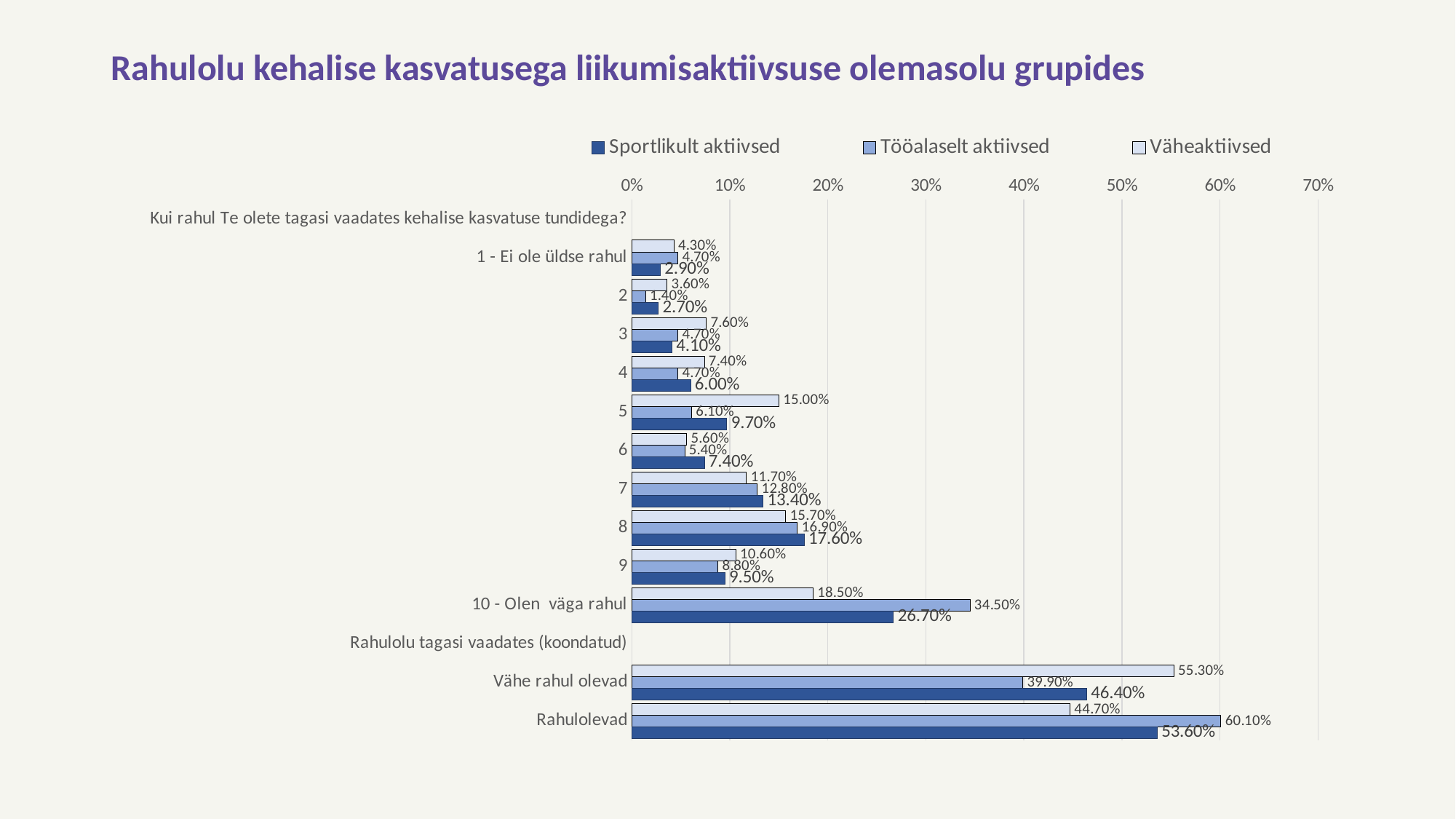
Which series has the highest value in the category '10 - Olen väga rahul'? Tööalaselt aktiivsed What is the value for Tööalaselt aktiivsed in the category 'Rahulolevad'? 60.10% How many series does the legend list? 3 What is the value for Väheaktiivsed in the category 'Vähe rahul olevad'? 55.30% What is the difference between the Tööalaselt aktiivsed and Väheaktiivsed values in the category '10 - Olen väga rahul'? 16.00% What is the value for Sportlikult aktiivsed in the category '10 - Olen väga rahul'? 26.70% Is the value for Sportlikult aktiivsed in the category 'Vähe rahul olevad' greater or less than 40%? greater Which is larger in the category 'Rahulolevad': the value for Sportlikult aktiivsed or the value for Väheaktiivsed? Sportlikult aktiivsed What kind of chart is shown on the slide? bar chart What is the value for Väheaktiivsed in category 5? 15.00% What is the title of the chart? Rahulolu kehalise kasvatusega liikumisaktiivsuse olemasolu grupides Which series has the lowest value in category 2? Tööalaselt aktiivsed